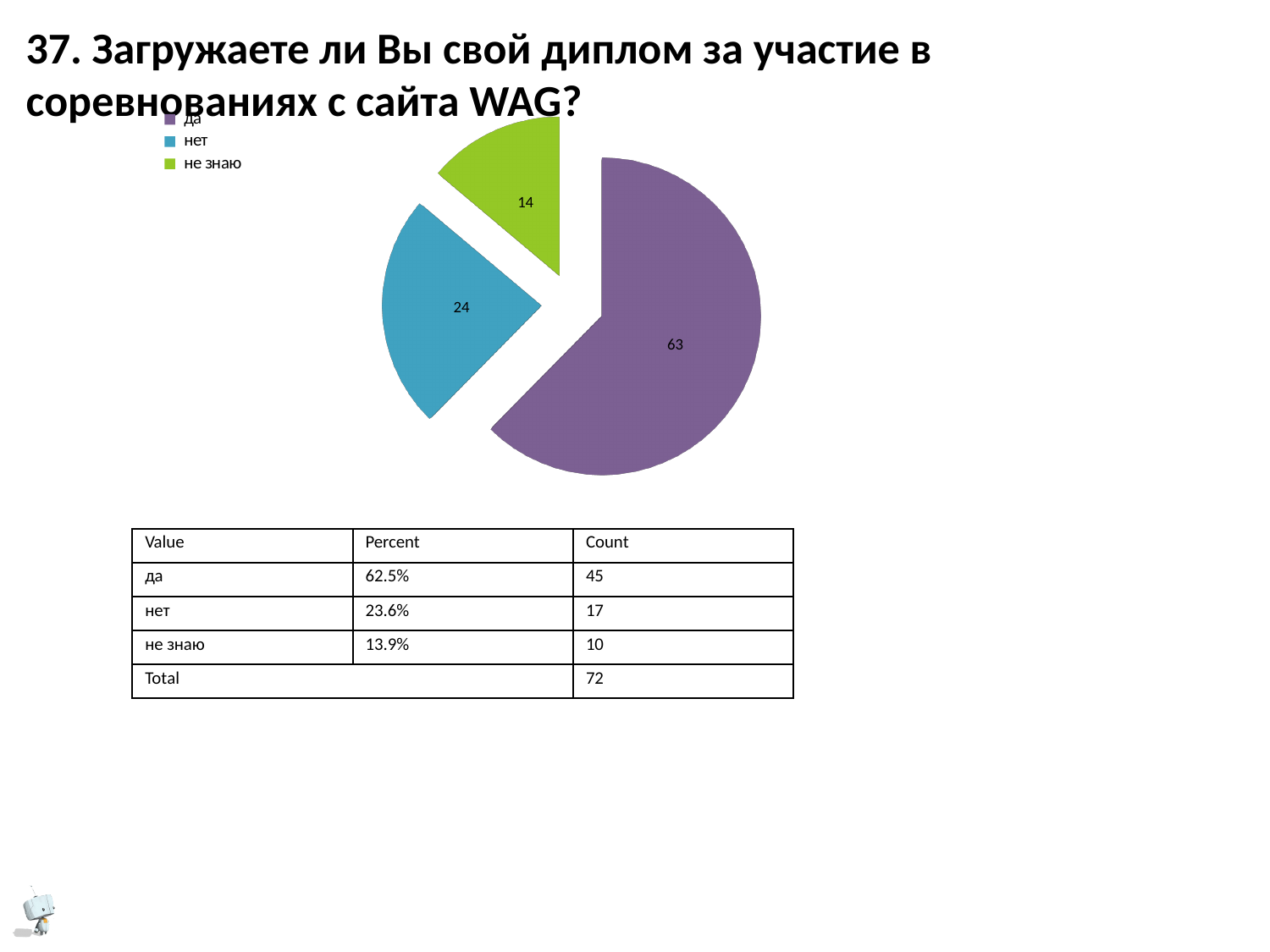
How many entries does the legend of the pie chart list? 3 What is the difference between the values printed on the "да" and "нет" slices? 39 What colour is the slice for "да" in the pie chart? purple What value is printed on the pie slice for "да"? 63 What colour is the slice for "не знаю" in the pie chart? green Which slice is larger, "нет" or "не знаю"? нет What value is printed on the pie slice for "нет"? 24 What kind of chart is shown on the slide? pie chart Which category has the smallest slice in the pie chart? не знаю How many slices does the pie chart have? 3 Which category has the largest slice in the pie chart? да What value is printed on the pie slice for "не знаю"? 14